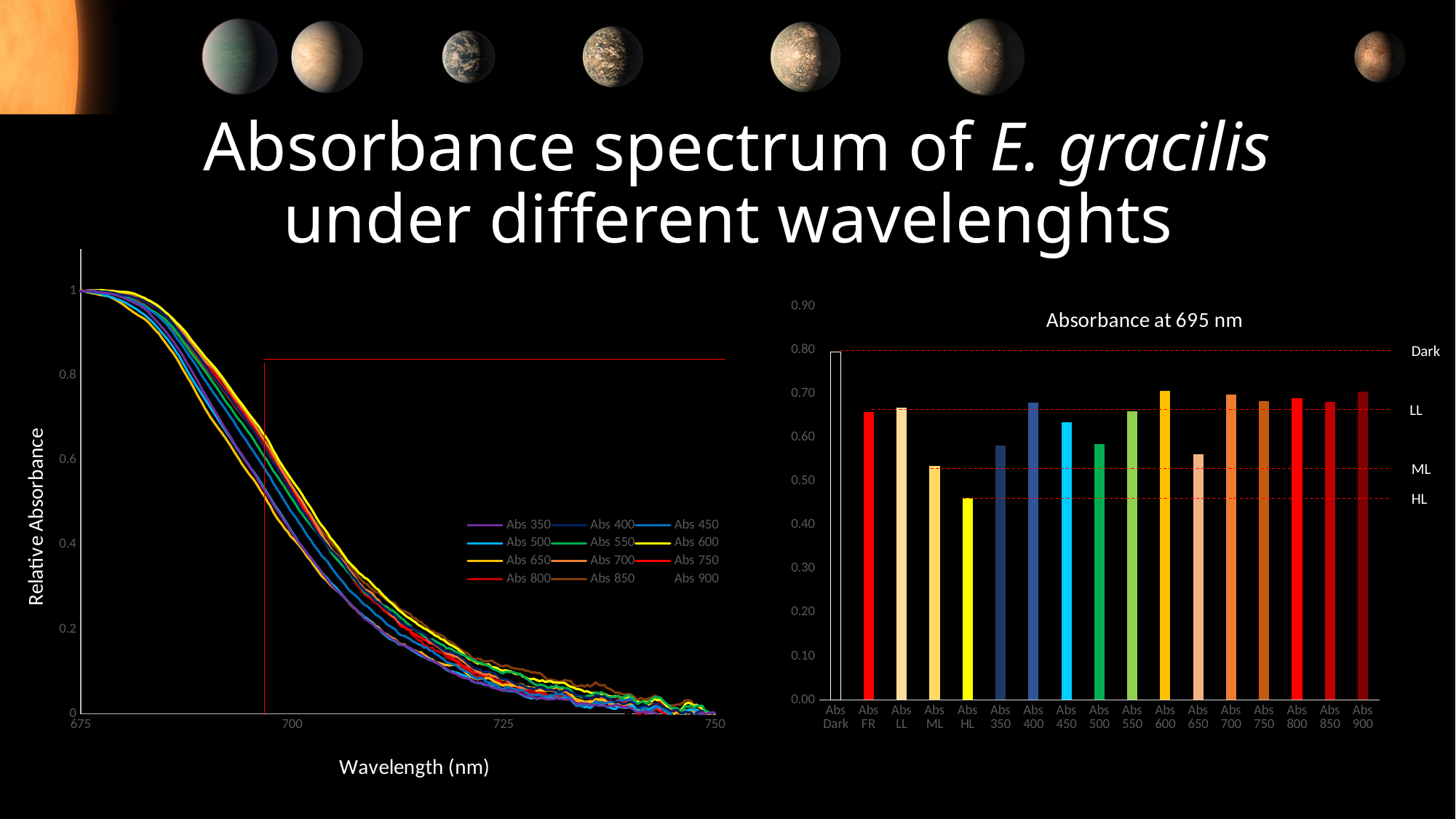
In the left chart, do the curves rise or fall as wavelength increases from 675 to 750 nm? fall What kind of chart is the 'Absorbance at 695 nm' chart on the right? bar chart In the 'Absorbance at 695 nm' chart, is the value for Abs Dark greater or less than 0.70? greater In the 'Absorbance at 695 nm' chart, which category has the highest bar? Abs Dark In the 'Absorbance at 695 nm' chart, how many bars are plotted? 17 In the 'Absorbance at 695 nm' chart, which category has the lowest bar? Abs HL In the 'Absorbance at 695 nm' chart, is the value for Abs HL greater or less than 0.50? less What kind of chart is the chart on the left of the slide? line chart In the 'Absorbance at 695 nm' chart, is the value for Abs 650 greater or less than 0.60? less In the 'Absorbance at 695 nm' chart, which is larger, the value for Abs 400 or the value for Abs 350? Abs 400 What is the x-axis label of the left chart? Wavelength (nm) In the left chart, how many series does the legend list? 12